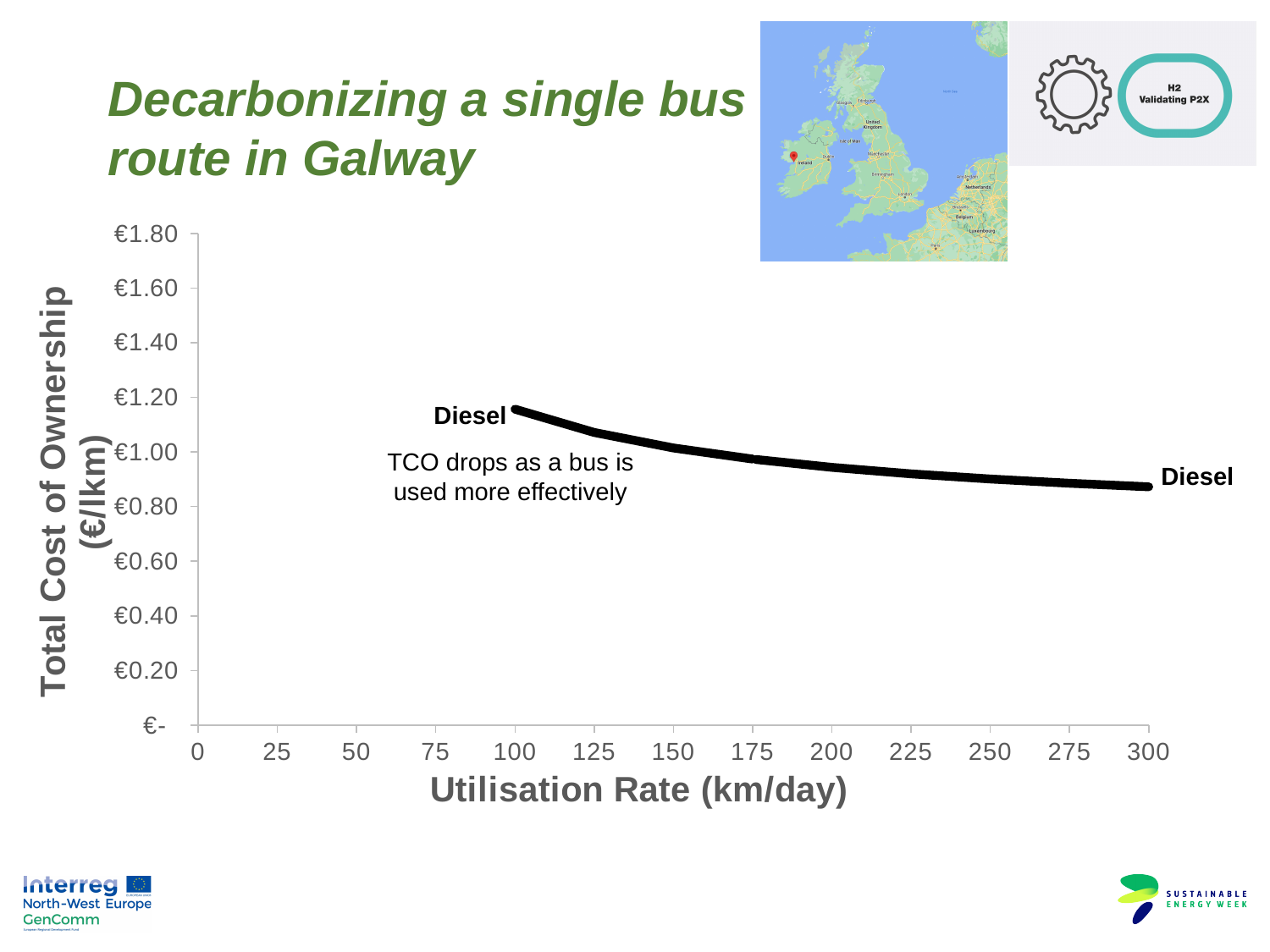
How many data series are plotted on the chart? 1 Is the Total Cost of Ownership for Diesel at a utilisation rate of 100 km/day greater or less than €1.20? less What is the highest value shown on the y axis? €1.80 Does the Total Cost of Ownership rise or fall as the Utilisation Rate increases? Falls What is the highest utilisation rate shown on the x axis? 300 What fuel type is the plotted line labelled as? Diesel Is the Total Cost of Ownership for Diesel at a utilisation rate of 100 km/day greater or less than €1.00? greater What is the label of the x axis? Utilisation Rate (km/day) Is the Total Cost of Ownership for Diesel at a utilisation rate of 300 km/day greater or less than €1.00? less What kind of chart is shown on the slide? Line chart Is the Total Cost of Ownership for Diesel higher at 100 km/day or at 300 km/day? 100 km/day